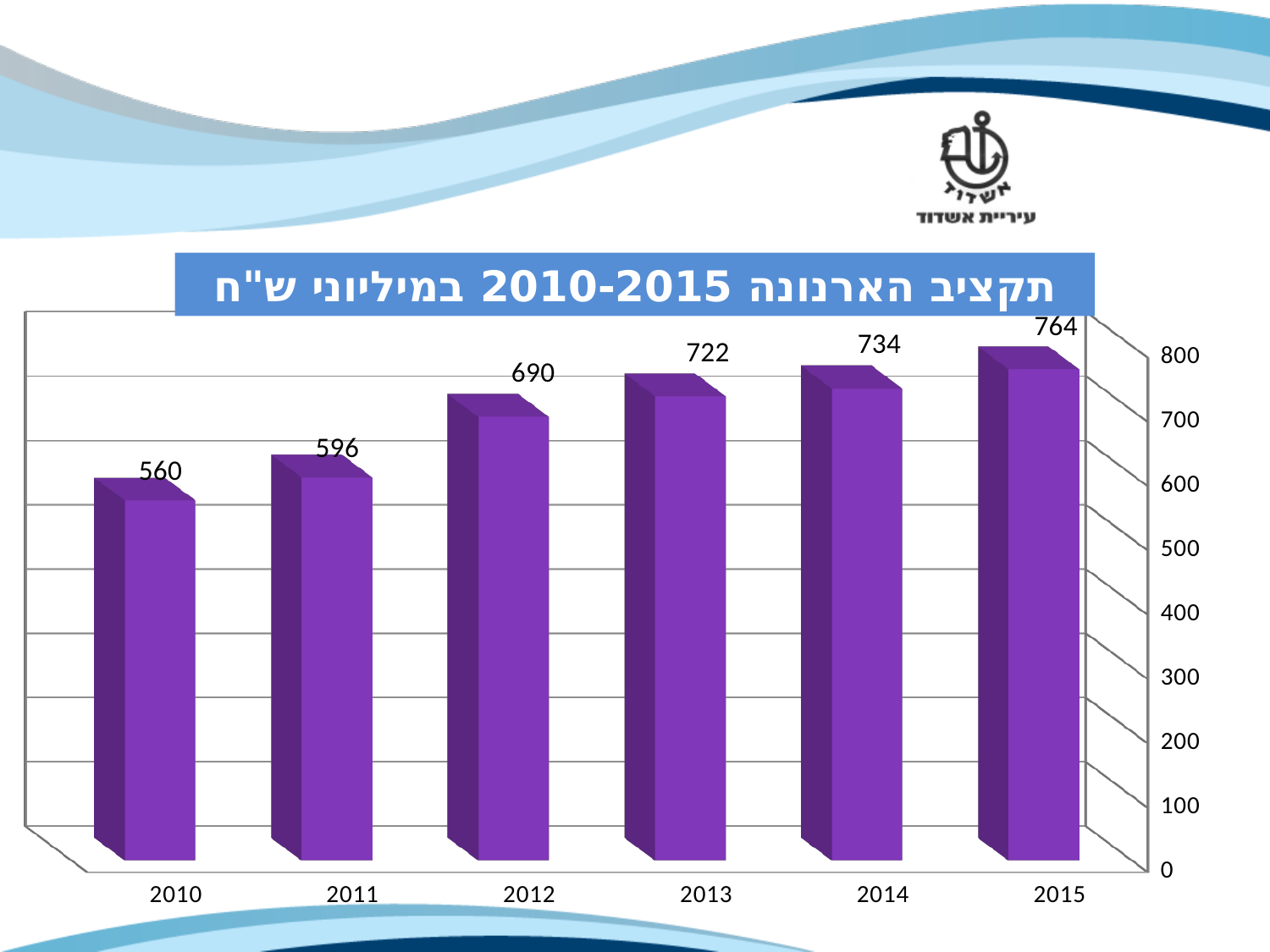
What is the value for 2013? 722 What kind of chart is shown on the slide? bar chart Which year has the lowest value? 2010 What is the value for 2010? 560 Which is larger, the value for 2014 or the value for 2013? 2014 What is the difference between the values for 2012 and 2011? 94 How many years are shown on the x axis? 6 What is the value for 2015? 764 Do the values rise or fall from 2010 to 2015? rise Which year has the highest value? 2015 Is the value for 2011 greater or less than 500? greater What is the difference between the values for 2015 and 2010? 204